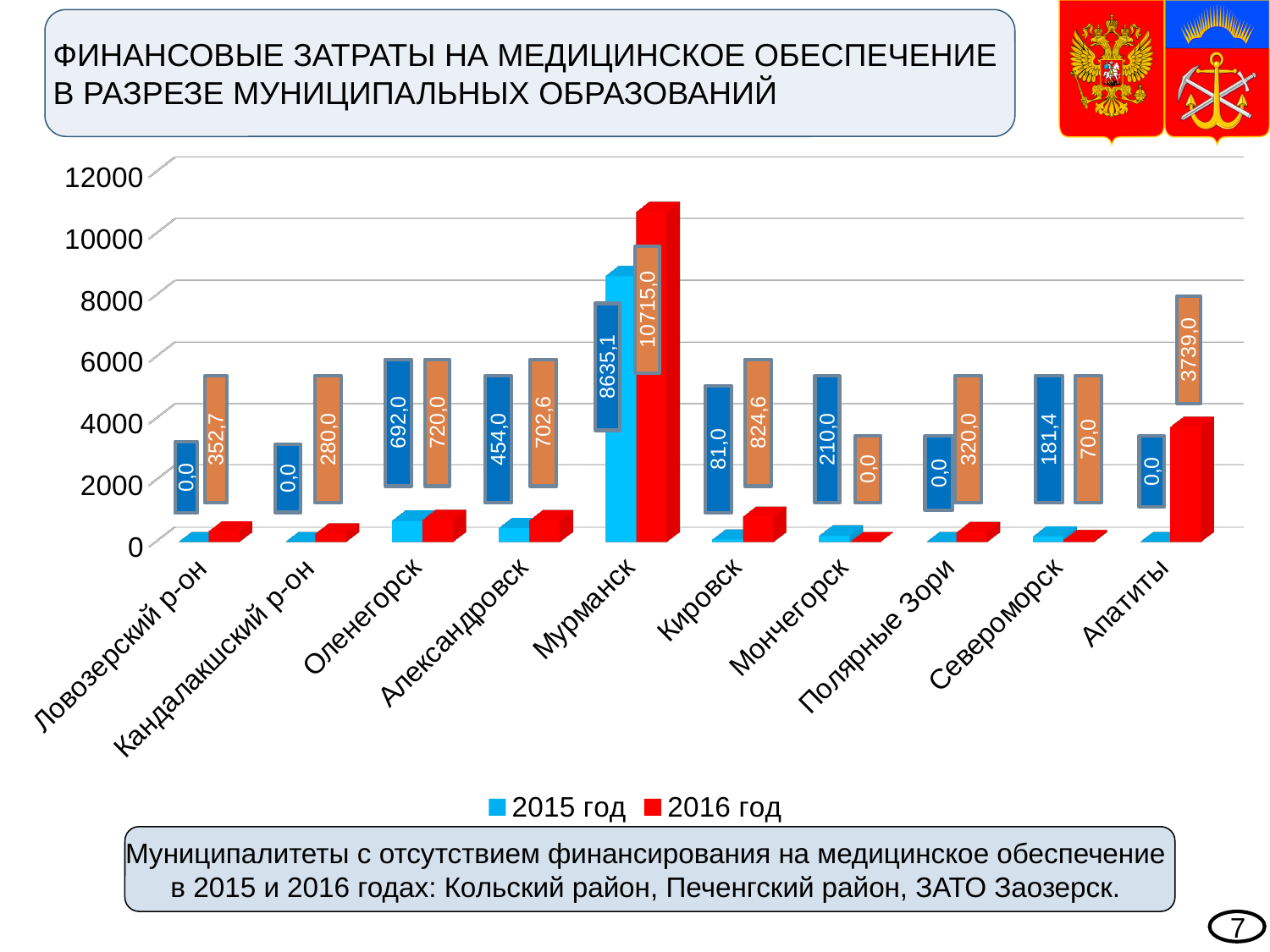
What is the 2015 год value for Оленегорск? 692,0 What is the 2015 год value for Североморск? 181,4 What kind of chart is shown on the slide? bar chart What is the 2016 год value for Мурманск? 10715,0 Which category has the lowest 2016 год value? Мончегорск Which colour represents the 2016 год series? red Which category has the highest 2016 год value? Мурманск What is the difference between the 2016 год and 2015 год values for Мурманск? 2079,9 How many categories are shown on the x axis? 10 What is the 2016 год value for Апатиты? 3739,0 Which is larger for Кировск: the 2015 год value or the 2016 год value? 2016 год How many series does the legend list? 2